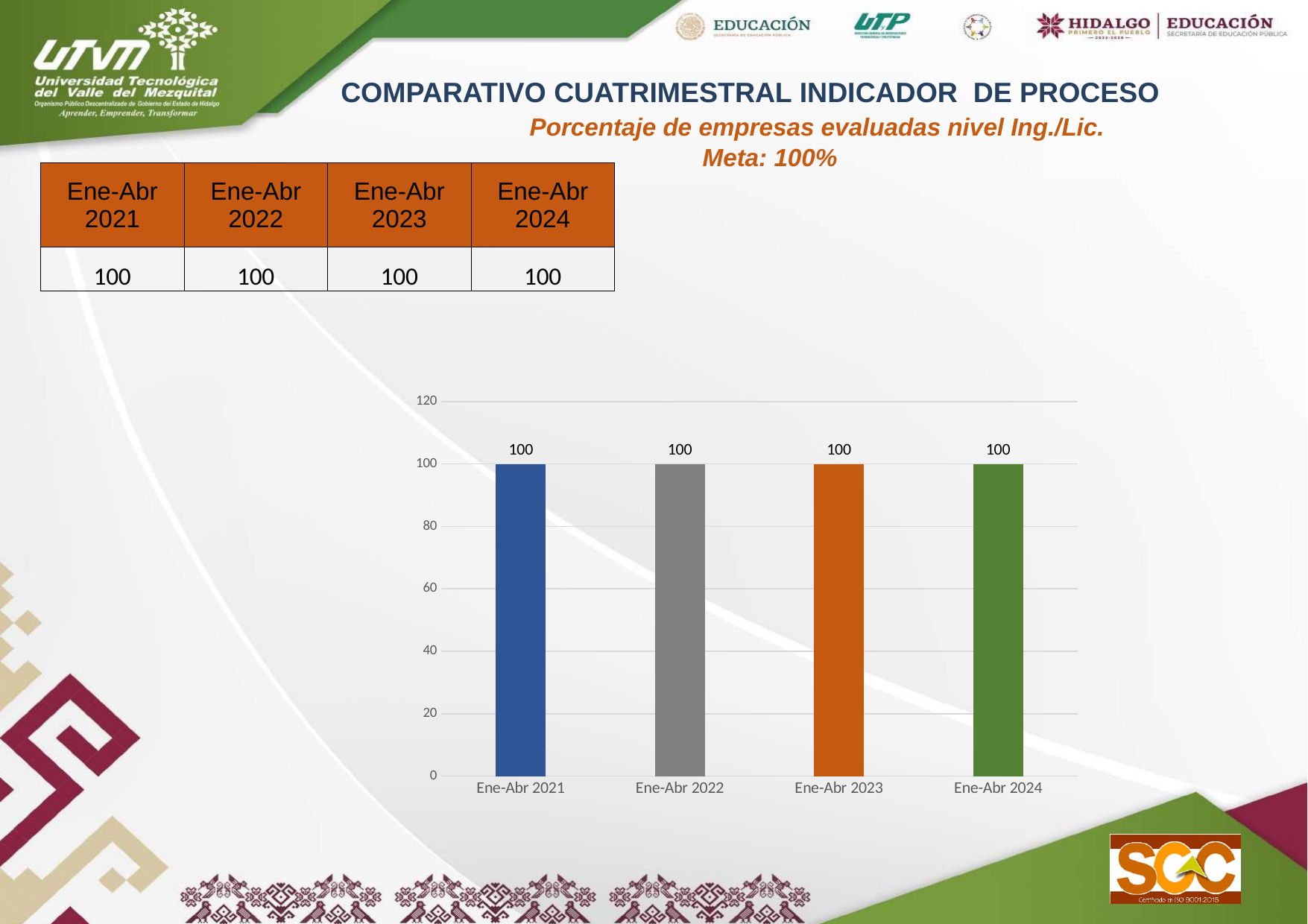
What is the value for Ene-Abr 2023? 100 Is the value for Ene-Abr 2022 greater or less than 120? less What colour is the bar for Ene-Abr 2024? green Is the value for Ene-Abr 2023 greater or less than 80? greater Do the values rise, fall, or stay the same from Ene-Abr 2021 to Ene-Abr 2024? stay the same What is the value for Ene-Abr 2024? 100 What is the highest value shown on the chart's vertical axis? 120 What is the difference between the values for Ene-Abr 2024 and Ene-Abr 2021? 0 What is the value for Ene-Abr 2022? 100 What kind of chart is shown on the slide? bar chart How many categories are shown on the x axis of the chart? 4 What is the value for Ene-Abr 2021? 100